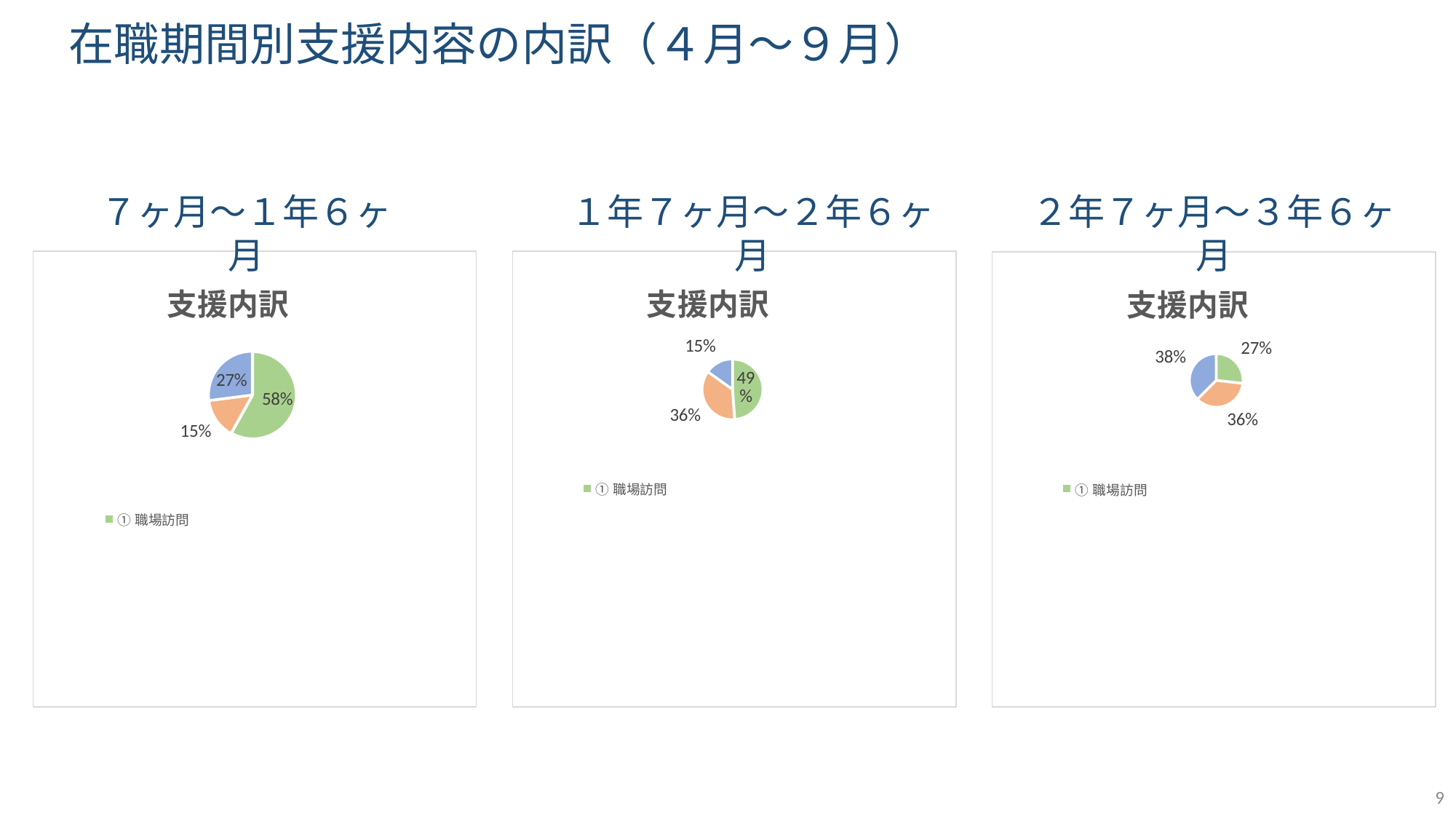
What kind of chart is used in each of the three panels on the slide? pie chart In the chart under the heading 7ヶ月〜1年6ヶ月, what share of the pie does ① 職場訪問 (the green slice) take? 58% In the chart under the heading 7ヶ月〜1年6ヶ月, what is the difference between the largest slice (58%) and the smallest slice (15%)? 43% How many slices does the pie chart under the heading 1年7ヶ月〜2年6ヶ月 have? 3 What is the title shown inside each of the three charts on the slide? 支援内訳 How many entries does the legend of the chart under the heading 7ヶ月〜1年6ヶ月 list? 1 In the chart under the heading 2年7ヶ月〜3年6ヶ月, what share of the pie does ① 職場訪問 (the green slice) take? 27% In the chart under the heading 1年7ヶ月〜2年6ヶ月, what share of the pie does ① 職場訪問 (the green slice) take? 49% In the chart under the heading 1年7ヶ月〜2年6ヶ月, what is the smallest percentage shown on the pie? 15% In the chart under the heading 7ヶ月〜1年6ヶ月, what is the largest percentage shown on the pie? 58% In the chart under the heading 2年7ヶ月〜3年6ヶ月, what is the largest percentage shown on the pie? 38% In the chart under the heading 2年7ヶ月〜3年6ヶ月, which is larger: the orange slice (36%) or the green slice (27%)? the orange slice (36%)